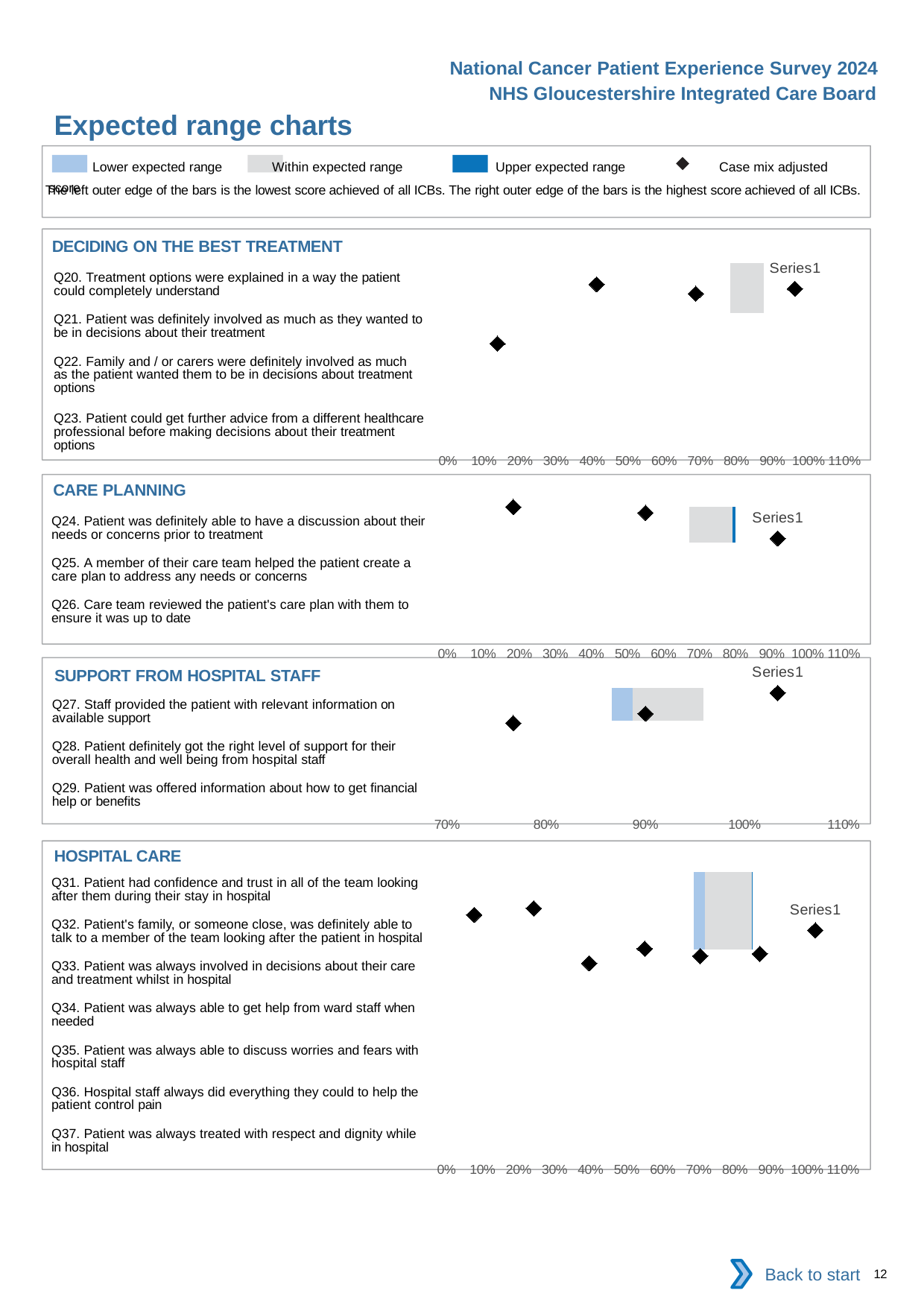
What is the highest value shown on the x axis of the 'Hospital care' chart? 110% What is the lowest value shown on the x axis of the 'Support from hospital staff' chart? 70% What is the legend entry shown in the 'Care planning' chart? Series1 How many series does the legend of the 'Hospital care' chart list? 1 How many series does the legend of the 'Deciding on the best treatment' chart list? 1 How many questions (categories) are listed in the 'Care planning' chart? 3 How many questions (categories) are listed in the 'Hospital care' chart? 7 How many questions (categories) are listed in the 'Deciding on the best treatment' chart? 4